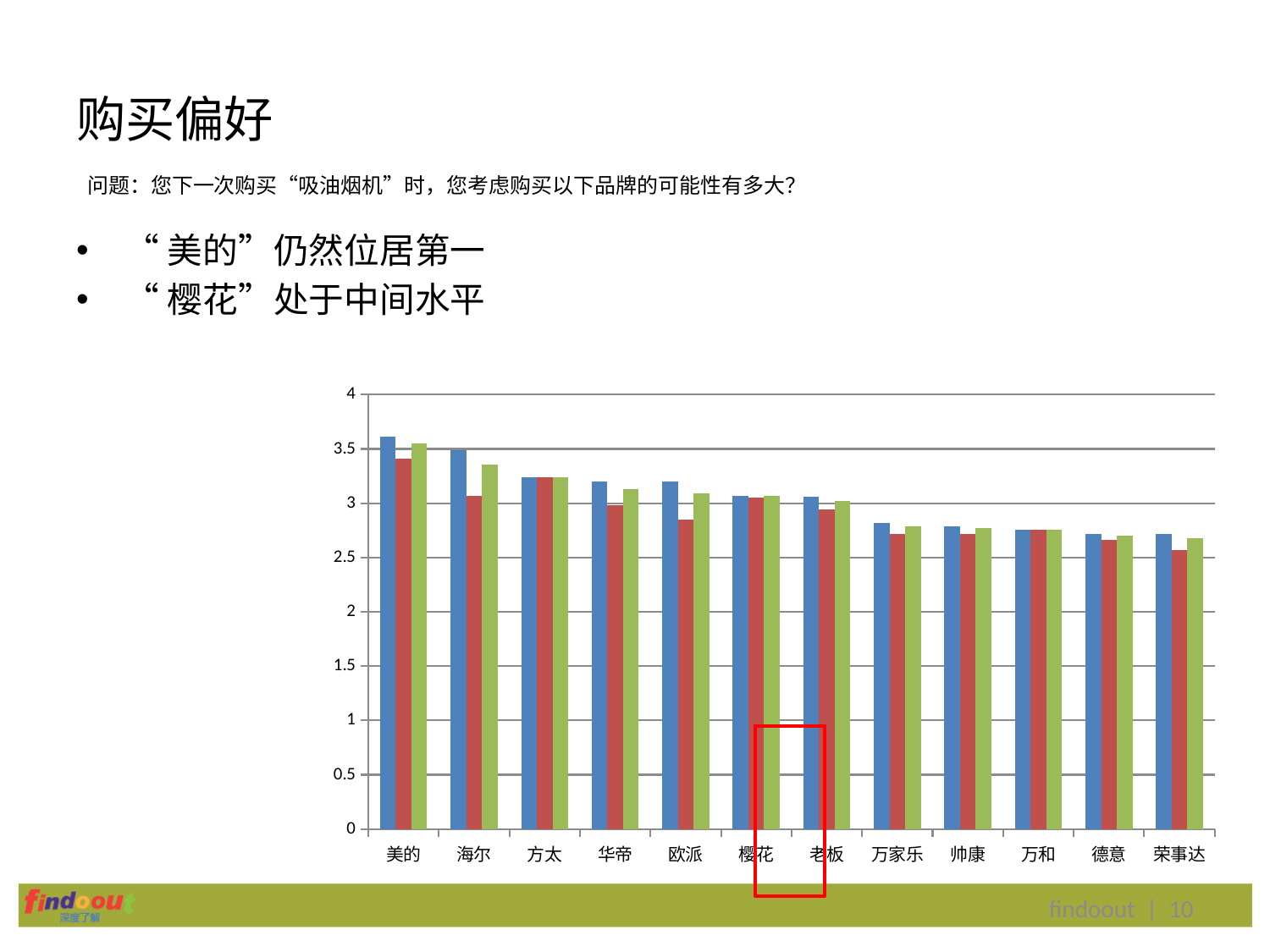
Is the blue bar for 万家乐 greater or less than 3? less Do the bar heights generally rise or fall from left to right across the brands? fall Is the red bar for 海尔 greater or less than 3? greater Which is taller: the blue bar for 海尔 or the red bar for 海尔? the blue bar Which brand has the shortest red bar in the chart? 荣事达 What kind of chart is shown on the slide? bar chart Which brand has the tallest blue bar in the chart? 美的 How many brands (categories) are shown on the x axis of the chart? 12 Is the red bar for 美的 greater or less than 3.5? less How many bars are plotted for each brand in the chart? 3